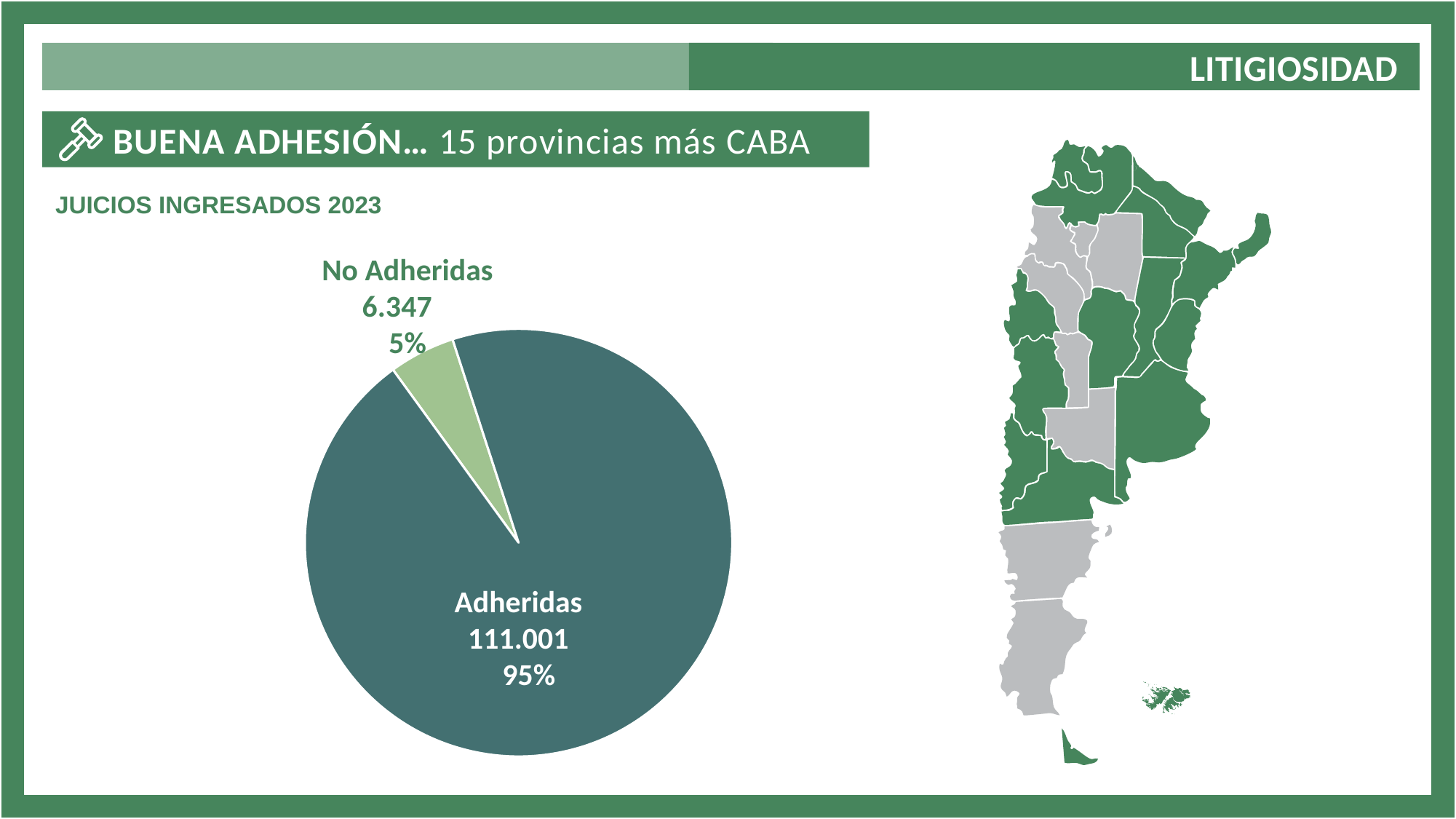
What is the value for No Adheridas in the pie chart? 6.347 What is the value for Adheridas in the pie chart? 111.001 Which is larger in the pie chart, Adheridas or No Adheridas? Adheridas What is the difference between the Adheridas and No Adheridas values in the pie chart? 104.654 What share of the pie does the No Adheridas slice represent? 5% What is the title printed above the pie chart? JUICIOS INGRESADOS 2023 What is the total of the two values shown in the pie chart? 117.348 Which slice of the pie chart is the largest? Adheridas What kind of chart is shown under 'JUICIOS INGRESADOS 2023'? pie chart What share of the pie does the Adheridas slice represent? 95% How many slices does the pie chart have? 2 Which slice of the pie chart is the smallest? No Adheridas